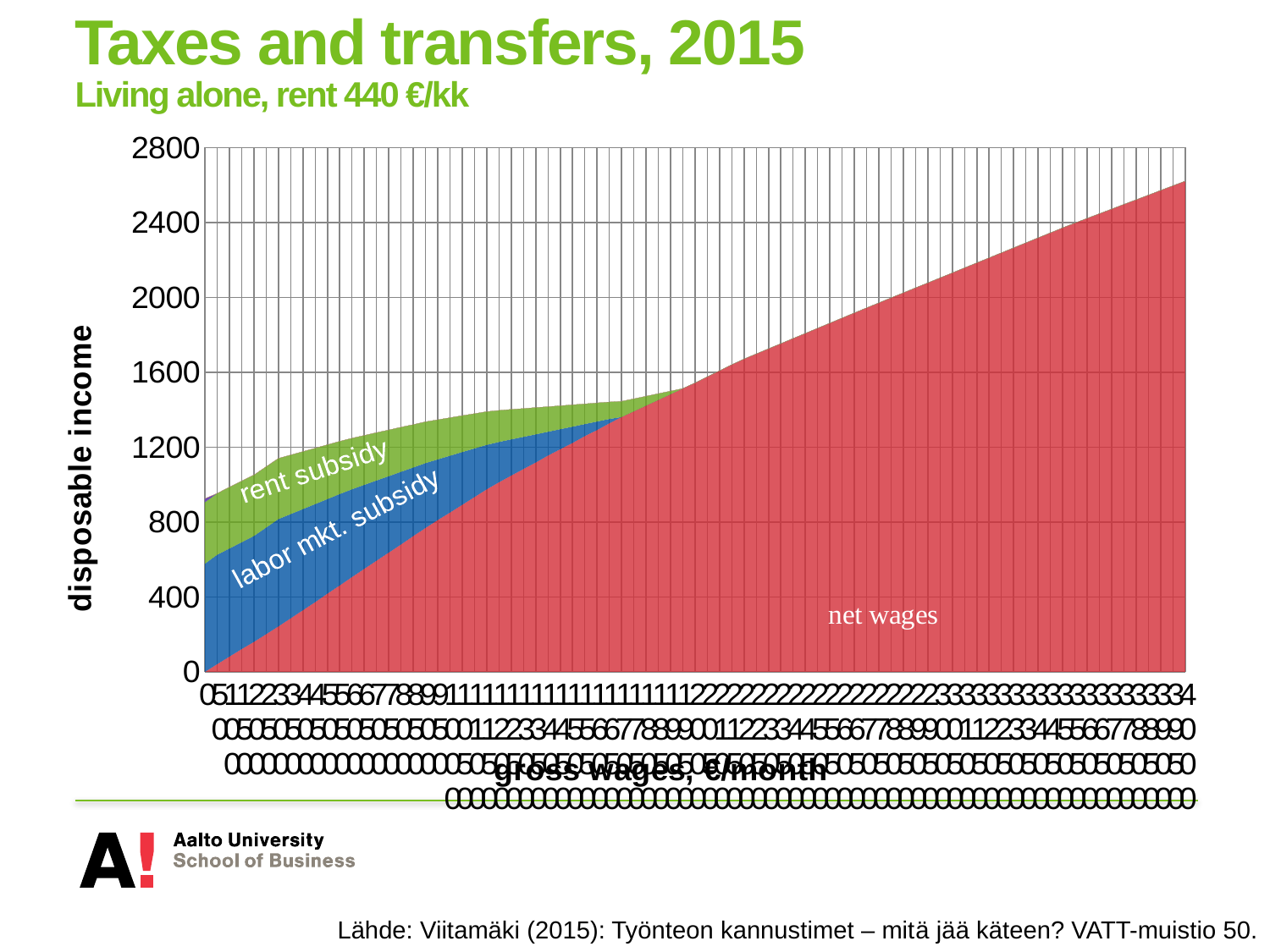
Which series is shown in red in the chart? net wages Which series is larger at the far left of the chart: labor mkt. subsidy or net wages? labor mkt. subsidy What is the title of the chart on the slide? Taxes and transfers, 2015 How many series (shaded areas) are shown in the chart? 3 What is the highest value shown on the vertical axis of the chart? 2800 Which series is larger at the right end of the chart: net wages or rent subsidy? net wages Is the total disposable income at the right end of the chart greater or less than 2400? greater Does the net wages area rise or fall as gross wages increase along the x axis? Rise Is the total disposable income at the left end of the chart greater or less than 1200? less What kind of chart is shown on the slide? Stacked area chart